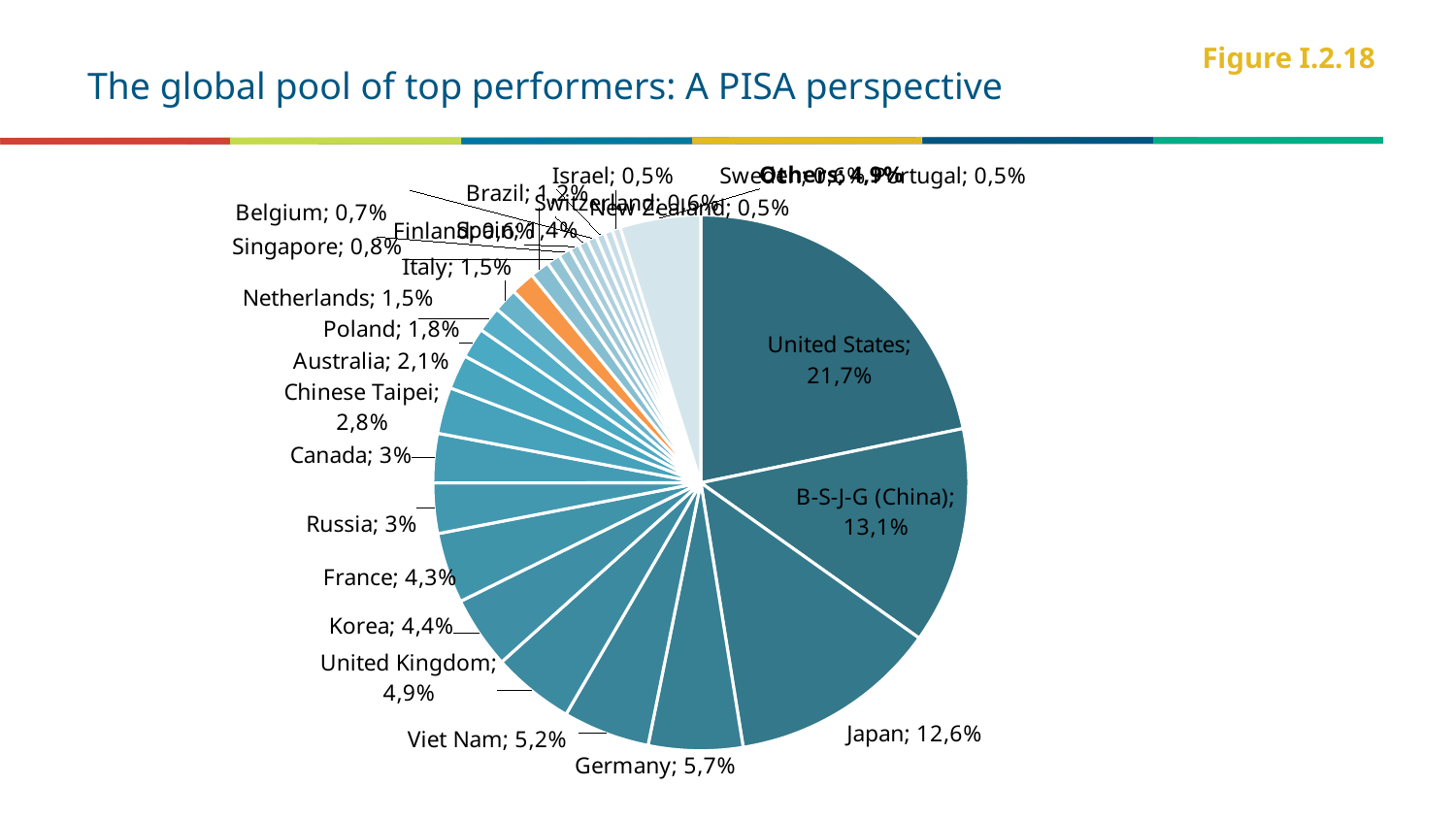
What percentage is shown for Germany? 5,7% What percentage is labelled for Chinese Taipei? 2,8% What is the value for the United Kingdom? 4,9% Which has a larger share, Australia or Poland? Australia What is the difference in percentage points between the United States and B-S-J-G (China)? 8,6 percentage points What share of the pie does the United States slice represent? 21,7% What type of chart is shown on the slide? Pie chart Which country has the largest slice of the pie? United States Which has a larger share, Viet Nam or Korea? Viet Nam What is the value labelled for Japan? 12,6% What is the title of the chart on the slide? The global pool of top performers: A PISA perspective What percentage is shown for B-S-J-G (China)? 13,1%